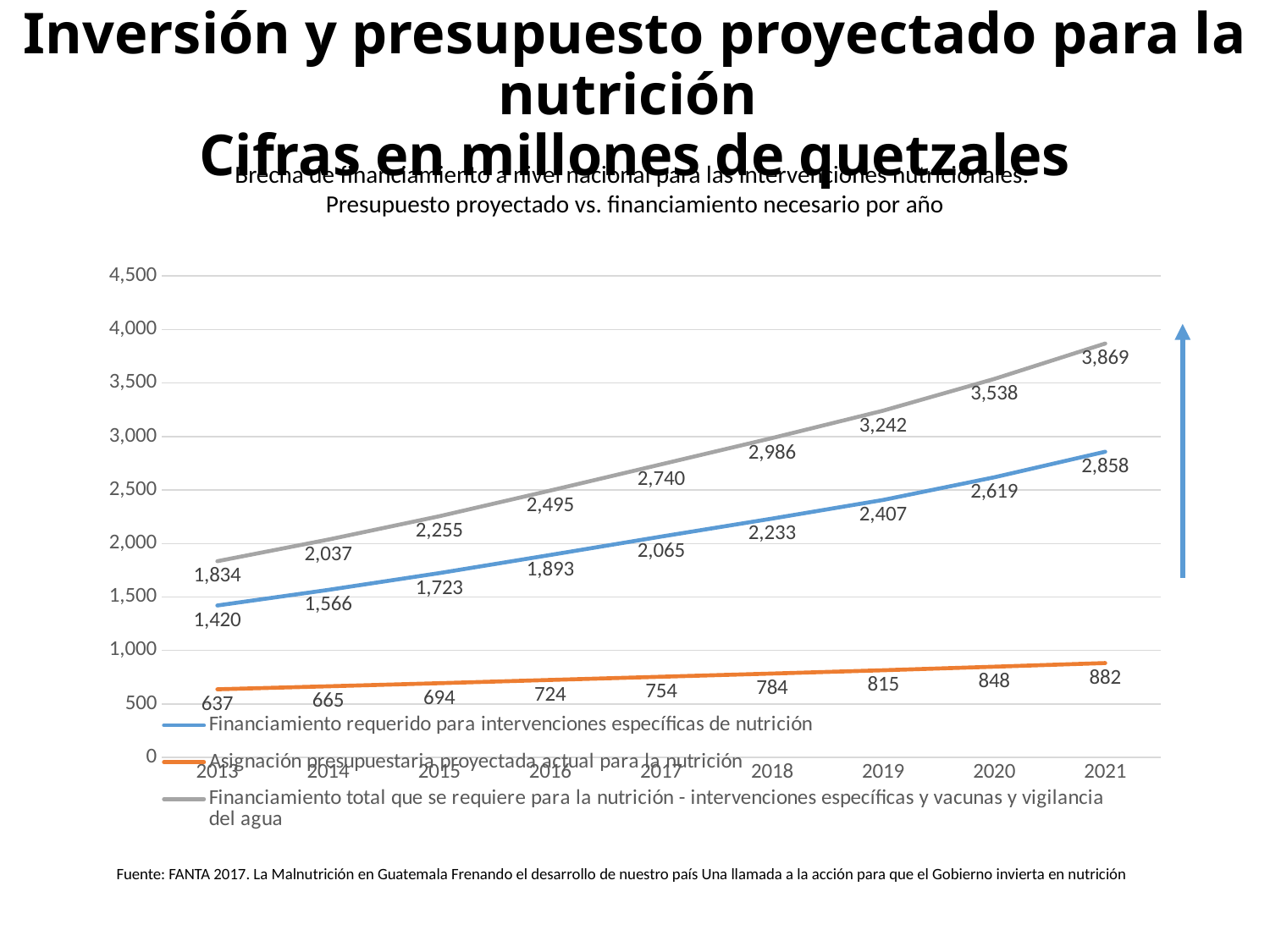
What is the value of the 'Financiamiento total que se requiere para la nutrición' series in 2017? 2,740 Do the values of the 'Asignación presupuestaria proyectada actual para la nutrición' series rise or fall from 2013 to 2021? rise In which year is the 'Financiamiento total que se requiere para la nutrición' series highest? 2021 What is the difference between the 'Financiamiento total que se requiere' value and the 'Asignación presupuestaria proyectada actual' value in 2021? 2,987 What type of chart is shown on the slide? line chart How many years are plotted along the x axis? 9 What colour is the line for 'Financiamiento requerido para intervenciones específicas de nutrición'? blue In which year is the 'Asignación presupuestaria proyectada actual para la nutrición' series lowest? 2013 How many series does the legend list? 3 What is the value of 'Asignación presupuestaria proyectada actual para la nutrición' in 2021? 882 What is the value of 'Financiamiento requerido para intervenciones específicas de nutrición' in 2013? 1,420 Which is larger in 2019: 'Financiamiento requerido para intervenciones específicas de nutrición' or 'Asignación presupuestaria proyectada actual para la nutrición'? Financiamiento requerido para intervenciones específicas de nutrición